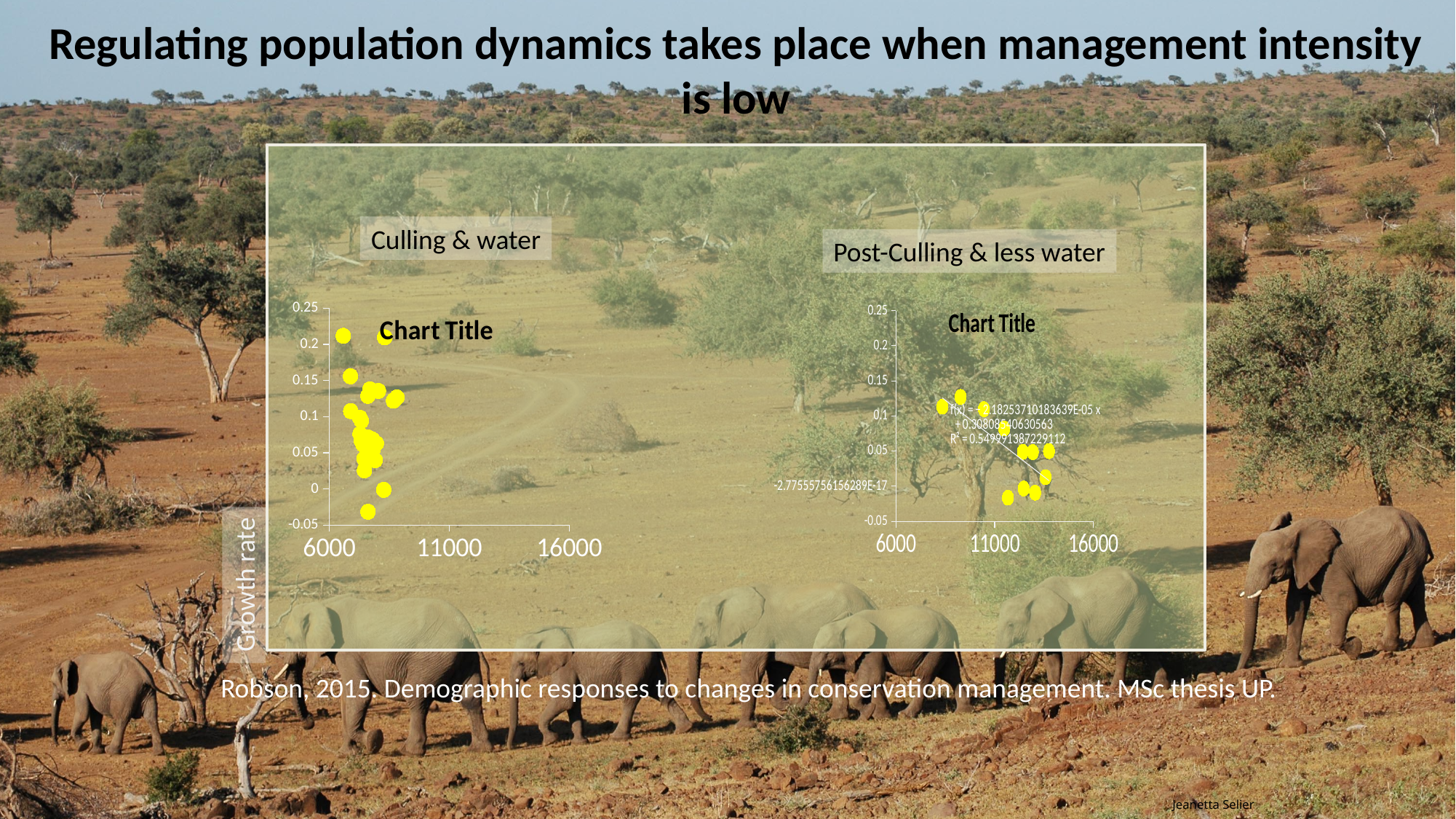
What kind of chart is the 'Post-Culling & less water' chart? scatter chart What is the label on the vertical axis of the charts? Growth rate Which chart has the higher maximum growth rate value, 'Culling & water' or 'Post-Culling & less water'? Culling & water What is the highest value shown on the vertical axis of the 'Culling & water' chart? 0.25 In the 'Culling & water' chart, are the points located at x-axis values greater or less than 11000? less In the 'Post-Culling & less water' chart, do the points tend to rise or fall as the x-axis value increases? fall How many charts are shown on the slide? 2 In the 'Culling & water' chart, is the lowest point greater or less than 0 on the vertical axis? less What kind of chart is the 'Culling & water' chart? scatter chart In the 'Post-Culling & less water' chart, is the highest point greater or less than 0.15 on the vertical axis? less What title is printed inside each of the two charts? Chart Title